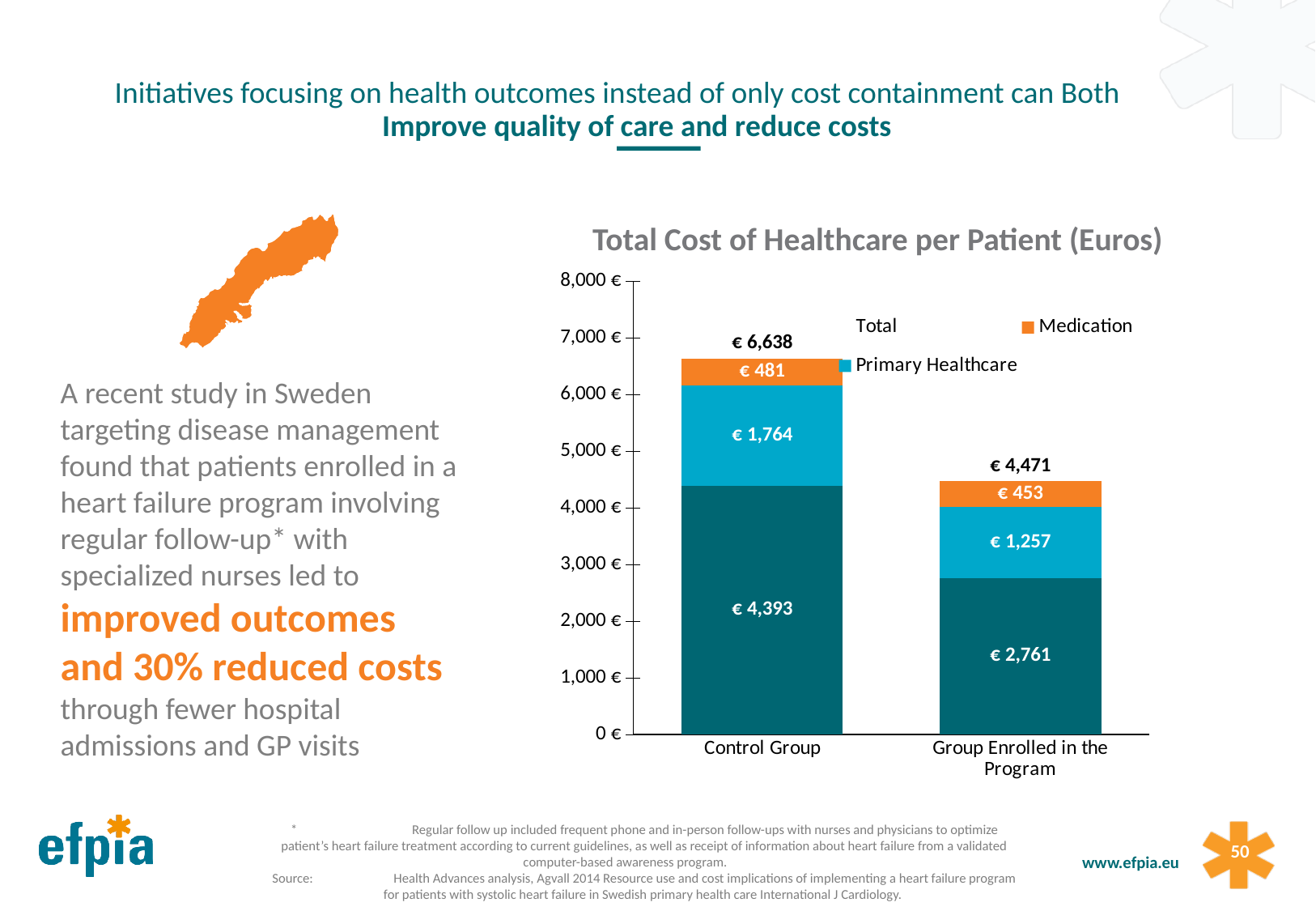
Which group has the highest total cost of healthcare per patient? Control Group Is the total cost for the Group Enrolled in the Program greater or less than 5,000 €? less How many groups are shown on the x axis of the chart? 2 What is the Medication value for the Control Group? € 481 What is the difference in Primary Healthcare cost between the Control Group and the Group Enrolled in the Program? € 507 What is the Primary Healthcare value for the Group Enrolled in the Program? € 1,257 What is the total cost per patient for the Group Enrolled in the Program? € 4,471 What is the value of the dark teal bottom segment of the Control Group bar? € 4,393 What is the difference between the total cost for the Control Group and the Group Enrolled in the Program? € 2,167 What is the total cost per patient for the Control Group? € 6,638 Which group has the higher Medication cost, the Control Group or the Group Enrolled in the Program? Control Group What type of chart is used to show the total cost of healthcare per patient? Stacked bar chart